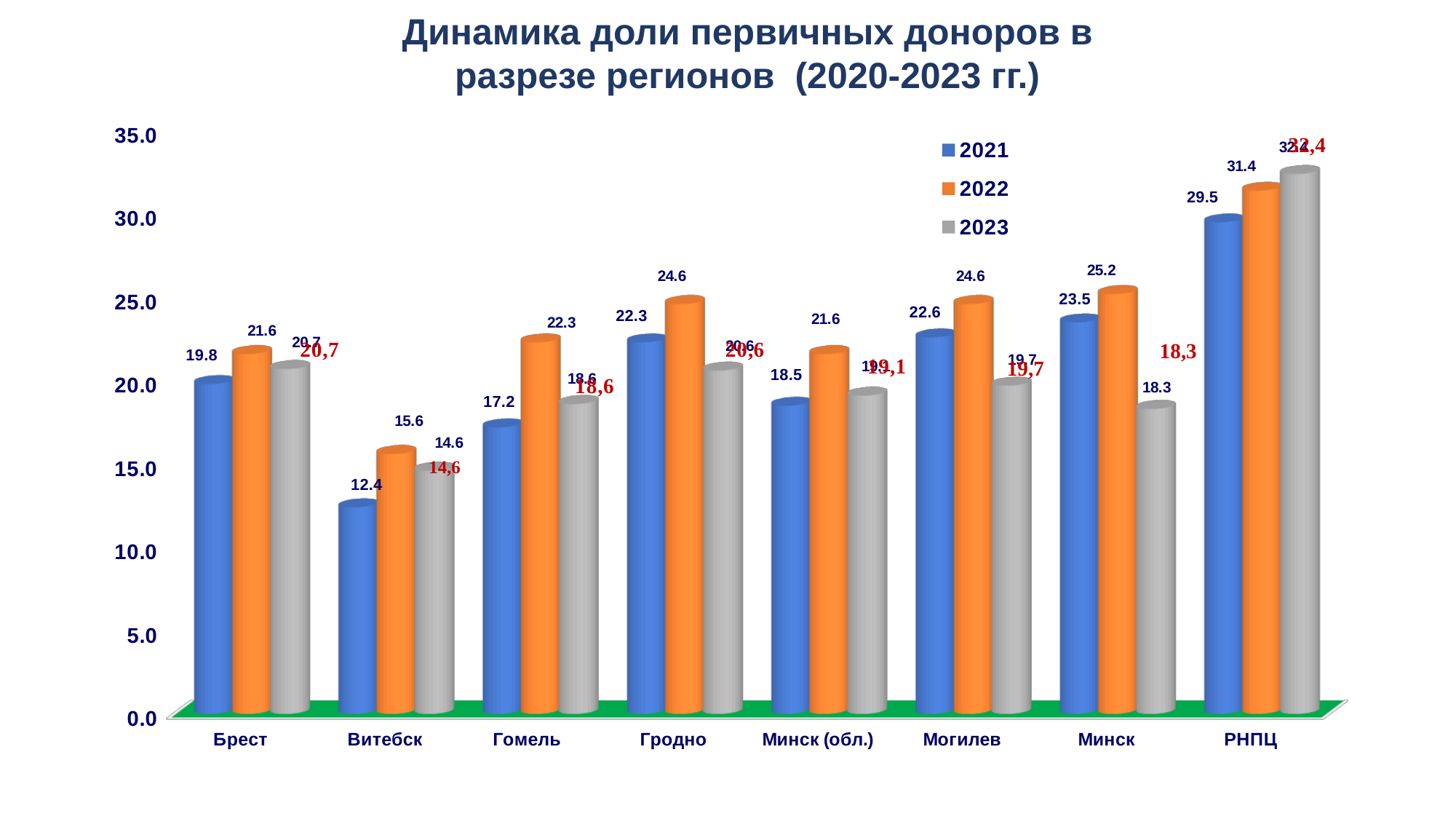
In the 2021 series, which is larger: Минск or Минск (обл.)? Минск What is the difference between the 2022 and 2021 values for РНПЦ? 1.9 How many regions are shown on the x axis? 8 How many series does the legend list? 3 What is the difference between the 2022 and 2021 values for Минск? 1.7 What is the value for Витебск in the 2022 series? 15.6 Which region has the highest value in the 2022 series? РНПЦ What kind of chart is shown on the slide? bar chart What is the value for РНПЦ in the 2021 series? 29.5 Is the 2021 value for Витебск greater or less than 15? less Which region has the lowest value in the 2021 series? Витебск What is the value for Гомель in the 2022 series? 22.3